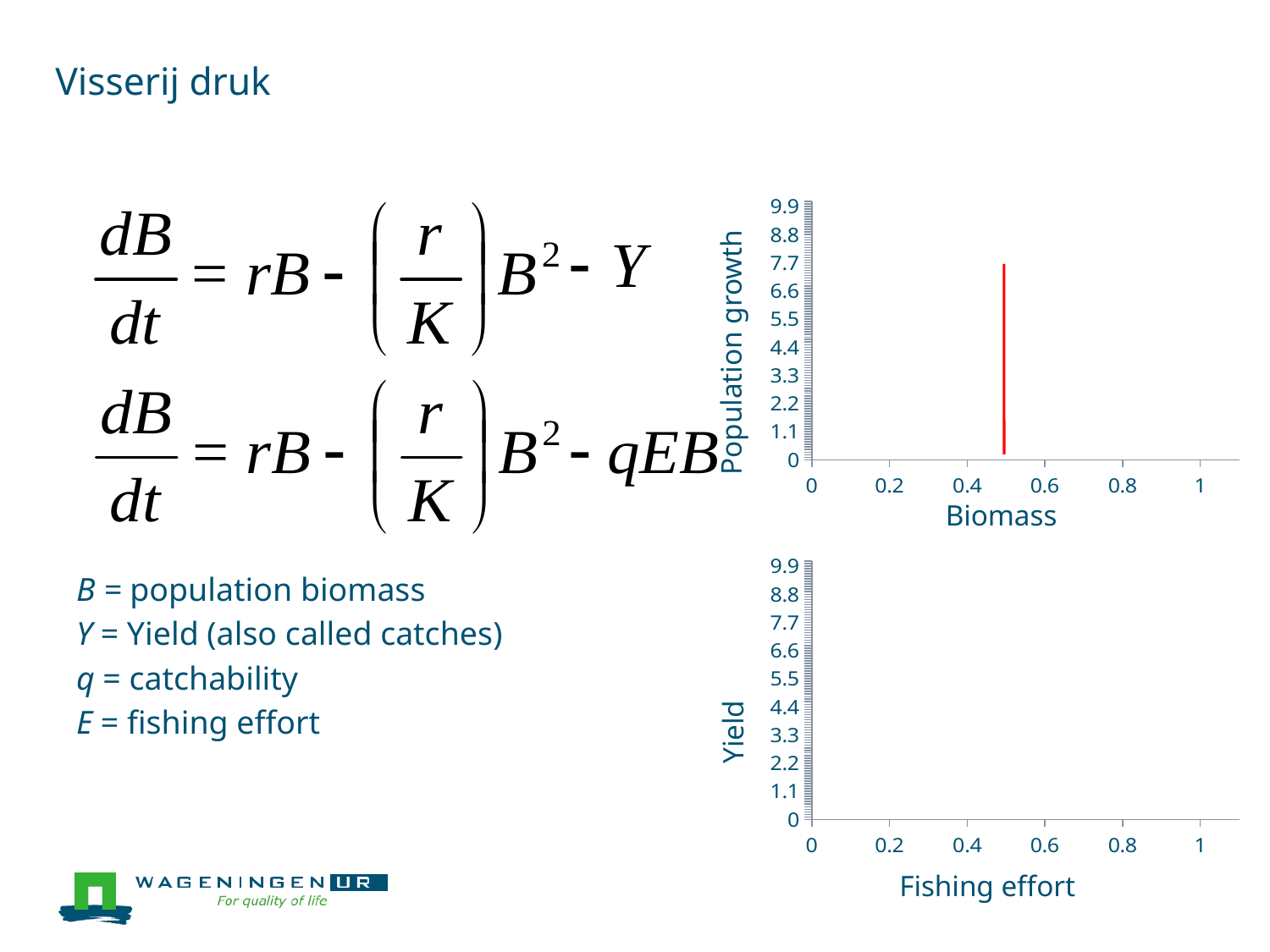
In the top chart (Population growth vs Biomass), is the red vertical line positioned at a biomass greater or less than 0.6? less In the top chart (Population growth vs Biomass), is the top of the red vertical line greater or less than 5.5? greater How many data points or lines are plotted in the bottom chart (Yield vs Fishing effort)? 0 How many red vertical lines are plotted in the top chart (Population growth vs Biomass)? 1 In the top chart, what is the label on the x axis? Biomass In the bottom chart, what is the label on the y axis? Yield In the top chart (Population growth vs Biomass), is the top of the red vertical line greater or less than 8.8? less